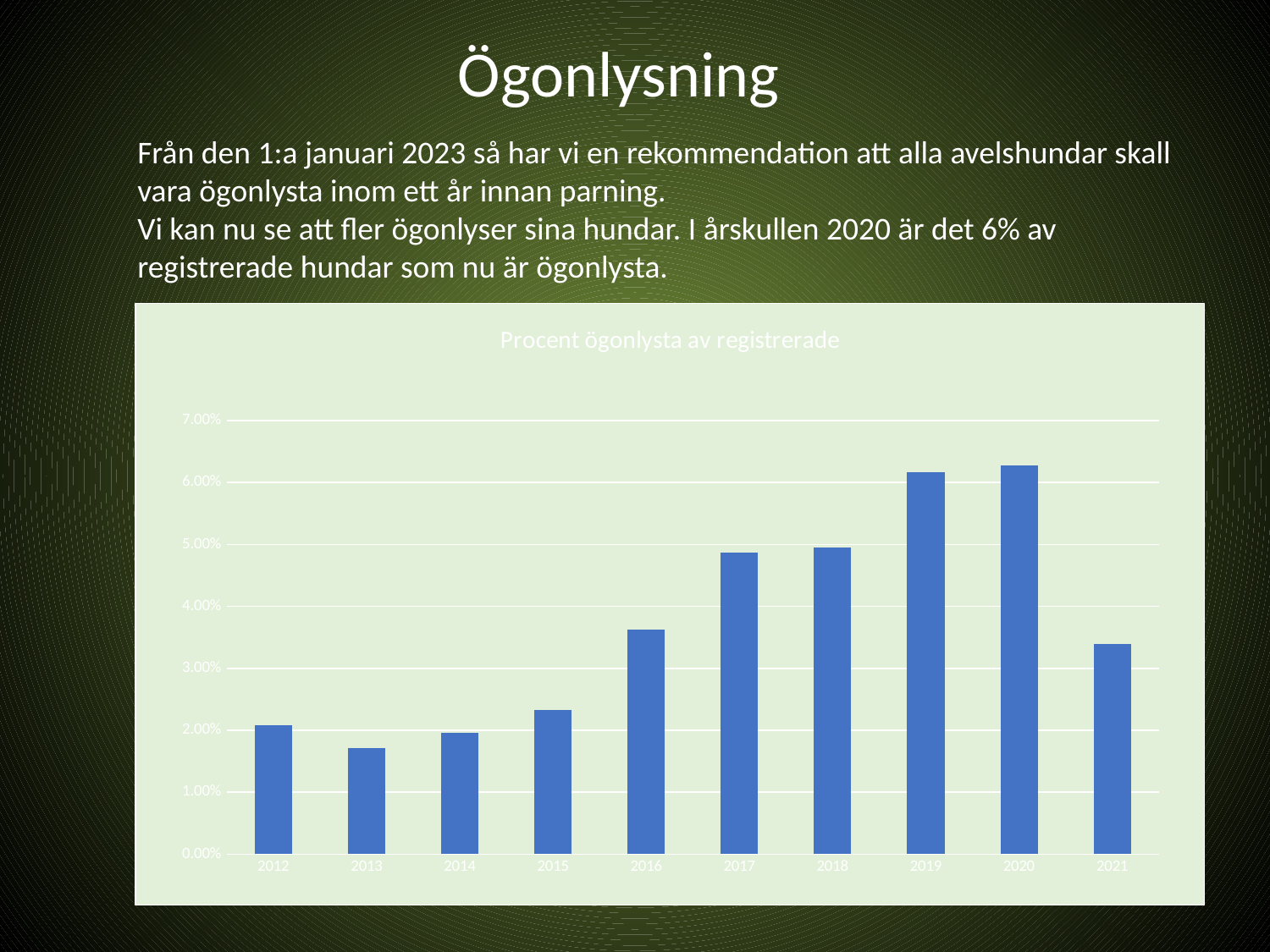
Is the value for 2017 greater or less than 5.00%? less What is the title of the chart? Procent ögonlysta av registrerade Do the values generally rise or fall from 2013 to 2020? rise What kind of chart is shown on the slide? bar chart Is the value for 2016 greater or less than 3.00%? greater Is the value for 2021 greater or less than 4.00%? less How many years are shown on the x axis of the chart? 10 Which year has the highest value in the chart? 2020 Which year has the larger value, 2018 or 2021? 2018 Which year has the larger value, 2015 or 2016? 2016 Which year has the lowest value in the chart? 2013